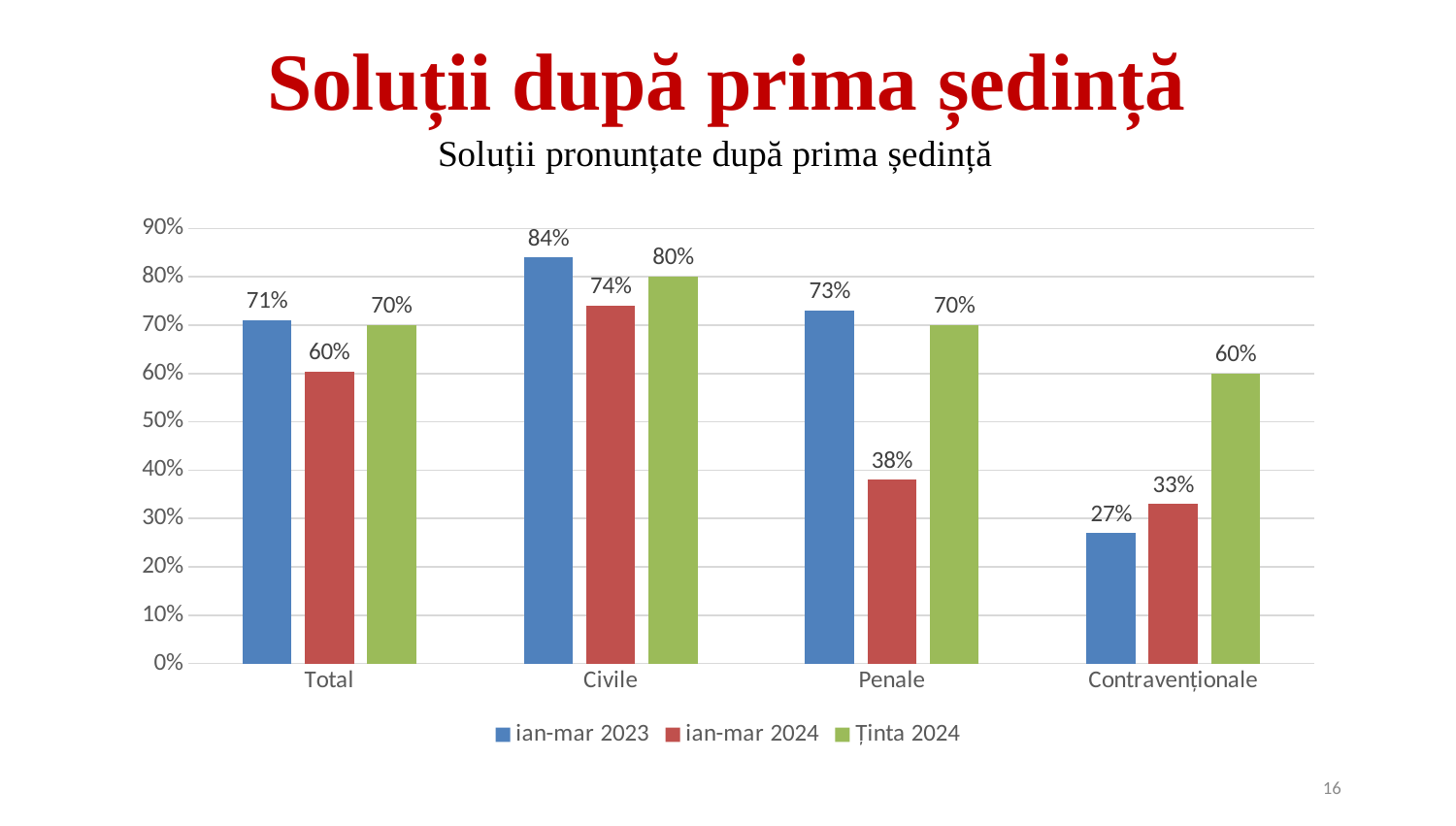
What is the difference between the ian-mar 2023 and ian-mar 2024 values for Penale? 35% What kind of chart is shown on the slide? Bar chart What is the value for Civile in the ian-mar 2023 series? 84% What is the value for Penale in the ian-mar 2024 series? 38% How many series does the legend list? 3 What colour are the bars for the Ținta 2024 series? Green Which category has the lowest value in the ian-mar 2023 series? Contravenționale What is the Ținta 2024 value for Contravenționale? 60% Which category has the highest value in the ian-mar 2024 series? Civile What is the title of the chart? Soluții pronunțate după prima ședință How many categories are shown on the x axis? 4 Which is larger for Total: the ian-mar 2023 value or the Ținta 2024 value? ian-mar 2023